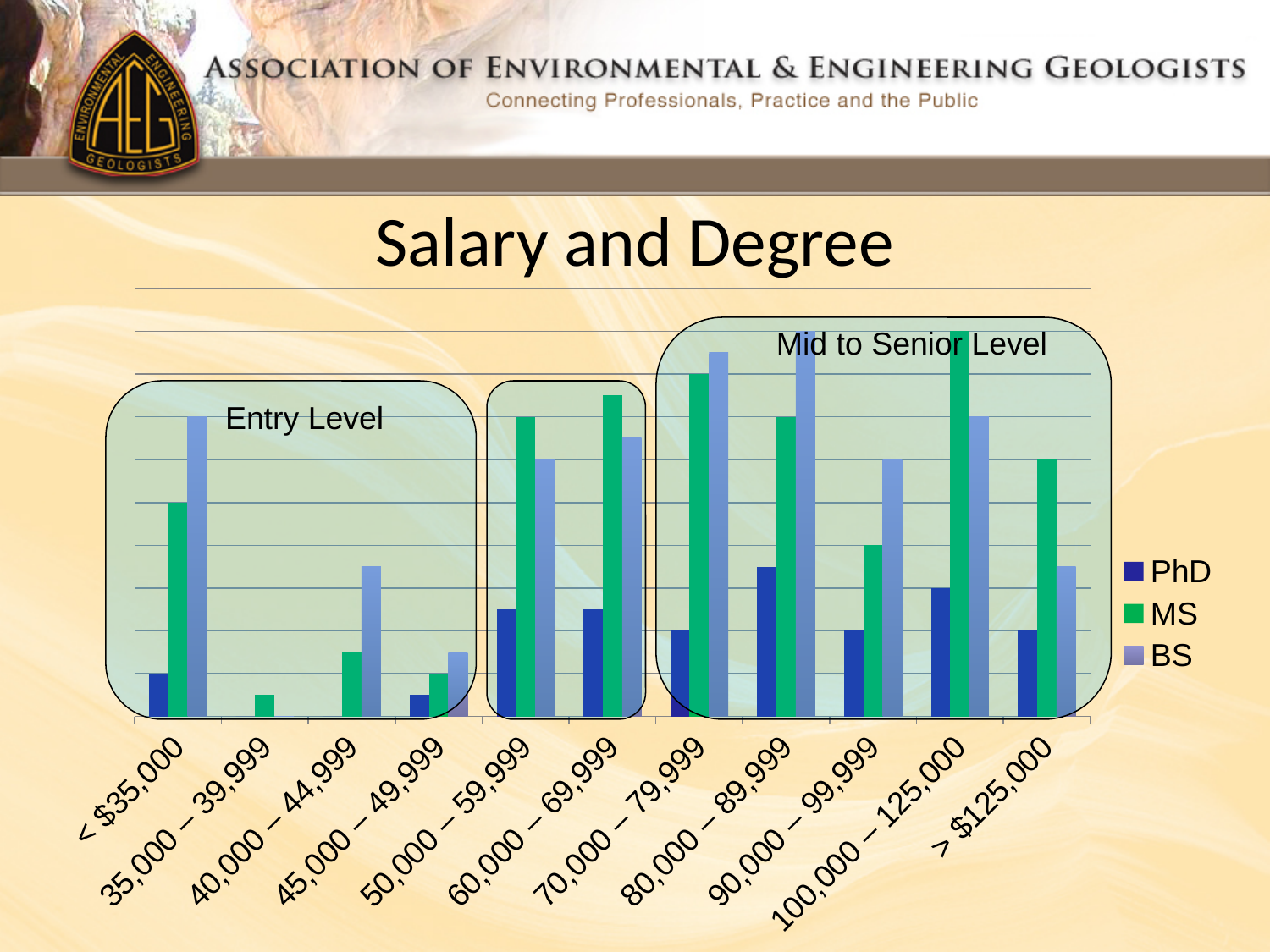
Which colour represents the MS series in the legend? green How many series does the legend list? 3 Which salary category has the tallest BS bar? 80,000 – 89,999 In the 60,000 – 69,999 category, which is larger, the MS bar or the BS bar? MS In the 45,000 – 49,999 category, which is larger, the BS bar or the PhD bar? BS In the < $35,000 category, which is larger, the BS bar or the MS bar? BS What is the title of the chart? Salary and Degree Which salary category has the tallest MS bar? 100,000 – 125,000 What kind of chart is shown on the slide? bar chart Which salary category has the tallest PhD bar? 80,000 – 89,999 How many salary categories are shown on the x axis? 11